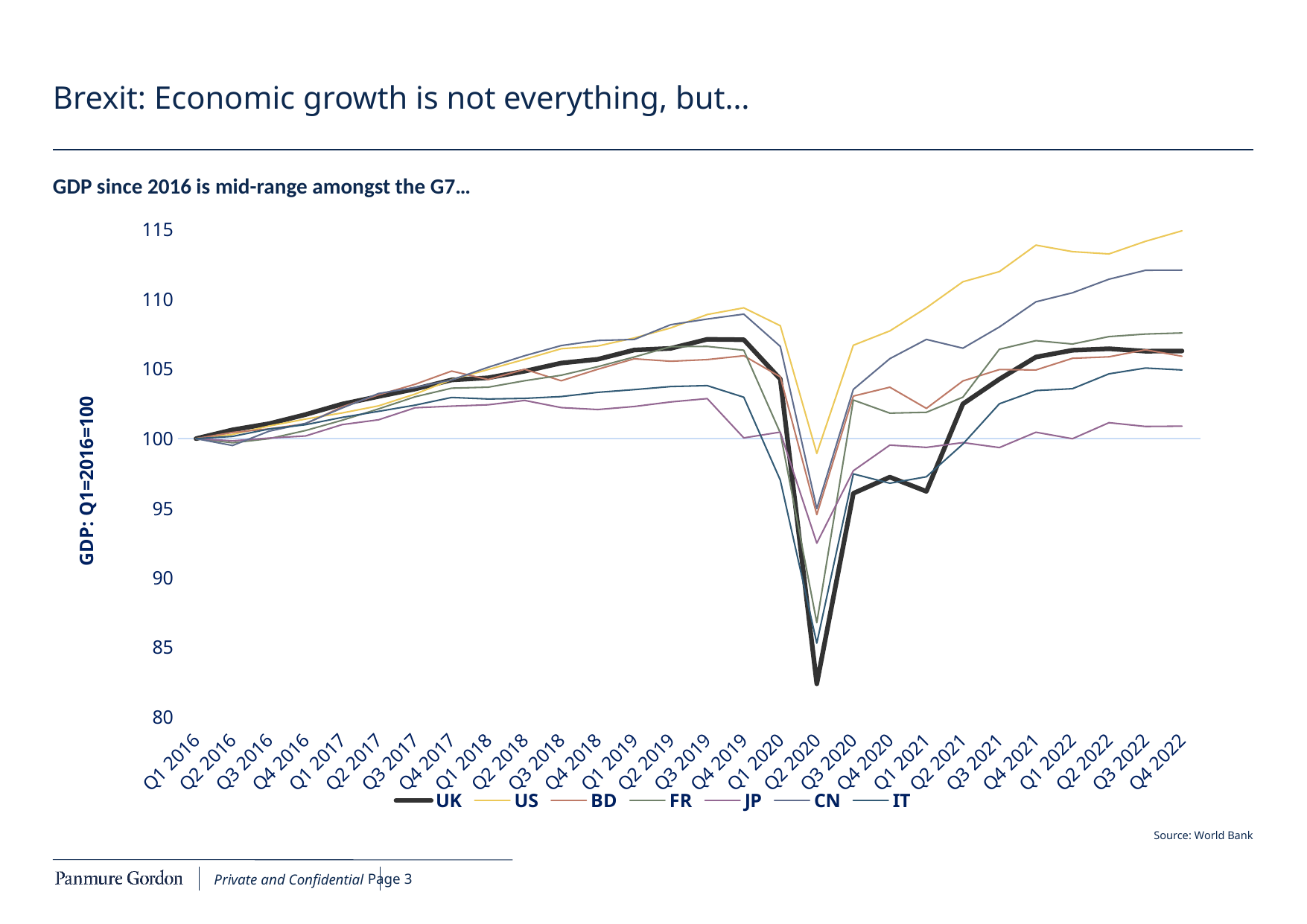
Which series has the lowest value at Q2 2020? UK Is the value for the US at Q4 2022 greater or less than 110? greater Which series has the highest value at Q4 2022? US What is the value of the UK series at Q1 2016? 100 Does the US series rise or fall from Q3 2020 to Q4 2022? Rise How many series does the legend list? 7 What kind of chart is shown on the slide? Line chart How many quarters are shown along the x axis? 28 What is the label on the y axis of the chart? GDP: Q1=2016=100 Which series has the lowest value at Q4 2022? JP Which is larger at Q4 2022, the value for US or the value for JP? US Is the value for the UK at Q2 2020 greater or less than 85? less